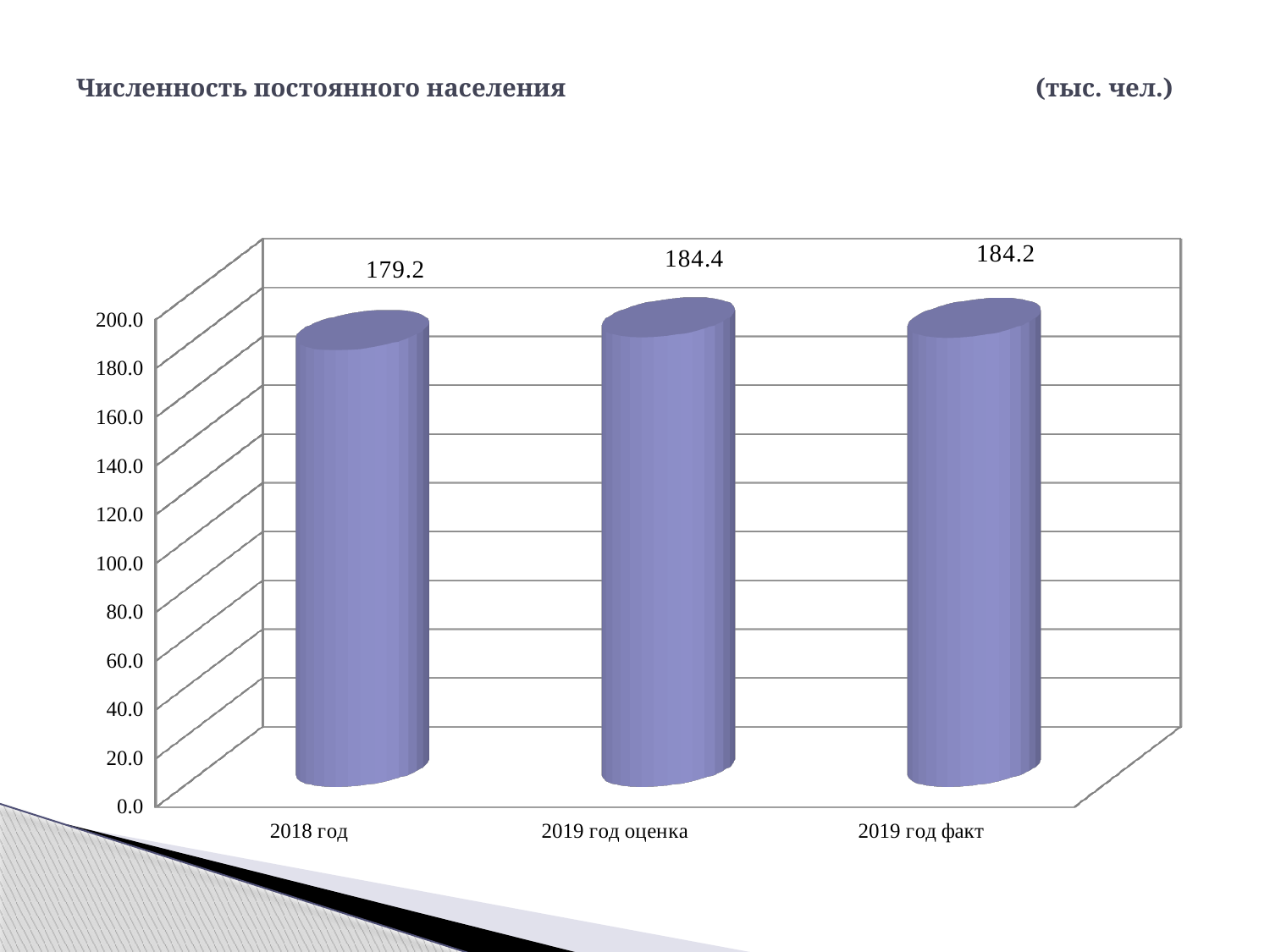
What is the difference between the values for 2019 год оценка and 2018 год? 5.2 What is the difference between the values for 2019 год оценка and 2019 год факт? 0.2 Which is larger, the value for 2018 год or the value for 2019 год факт? 2019 год факт What is the title of the chart on the slide? Численность постоянного населения (тыс. чел.) Which category has the lowest value? 2018 год What is the value for 2018 год? 179.2 How many categories are shown on the chart? 3 Is the value for 2018 год greater or less than 160.0? greater What kind of chart is shown on the slide? bar chart What is the value for 2019 год оценка? 184.4 Which category has the highest value according to the data labels? 2019 год оценка What is the value for 2019 год факт? 184.2